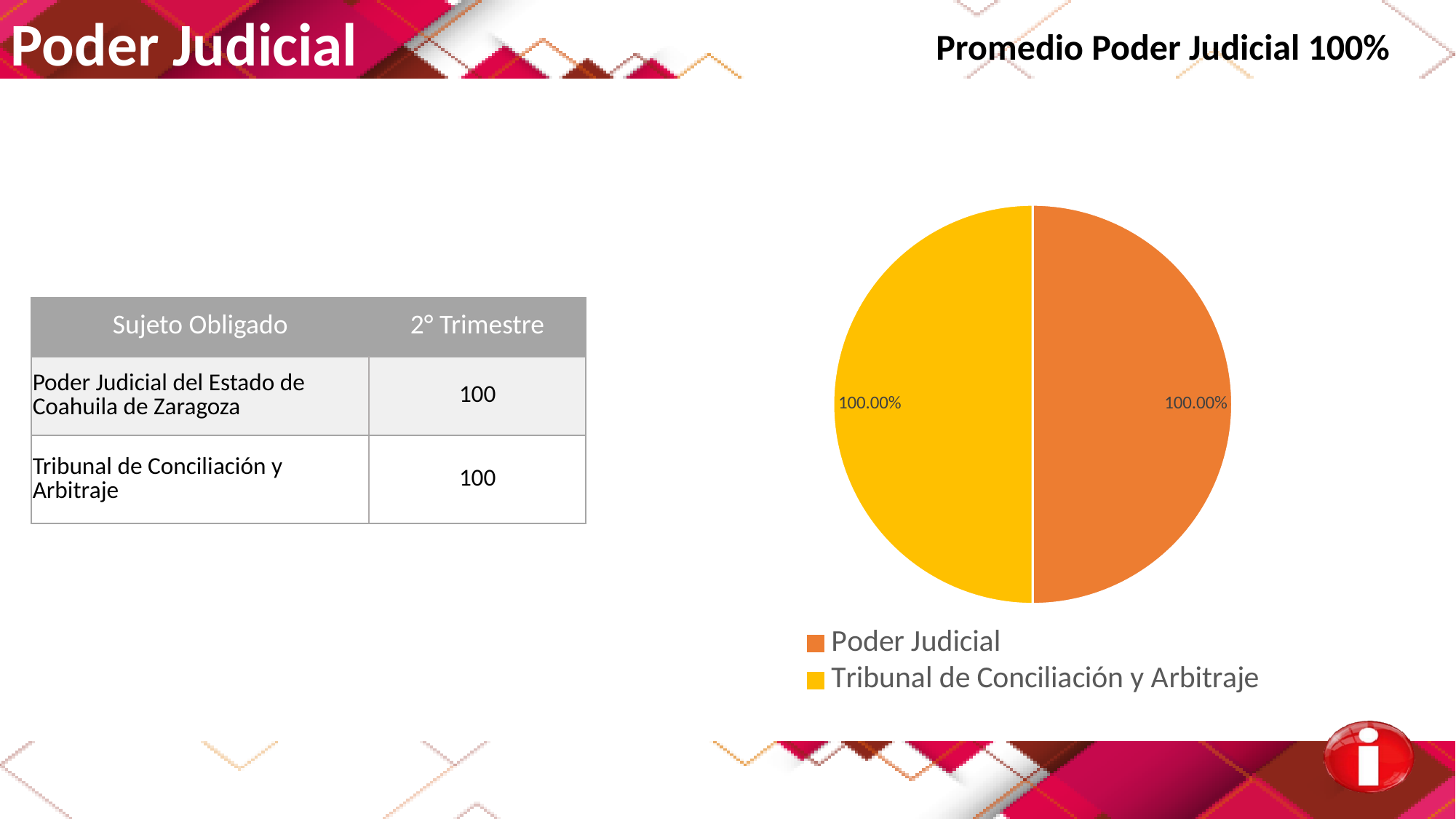
How many entries does the legend of the pie chart list? 2 Which legend entry is shown in yellow in the pie chart? Tribunal de Conciliación y Arbitraje What colour is the Poder Judicial slice in the pie chart? orange How many slices does the pie chart have? 2 What value is labelled on the Poder Judicial slice of the pie chart? 100.00% What value is labelled on the Tribunal de Conciliación y Arbitraje slice of the pie chart? 100.00% Is the value labelled on the Poder Judicial slice greater or less than 50%? greater What kind of chart is shown on the slide? pie chart